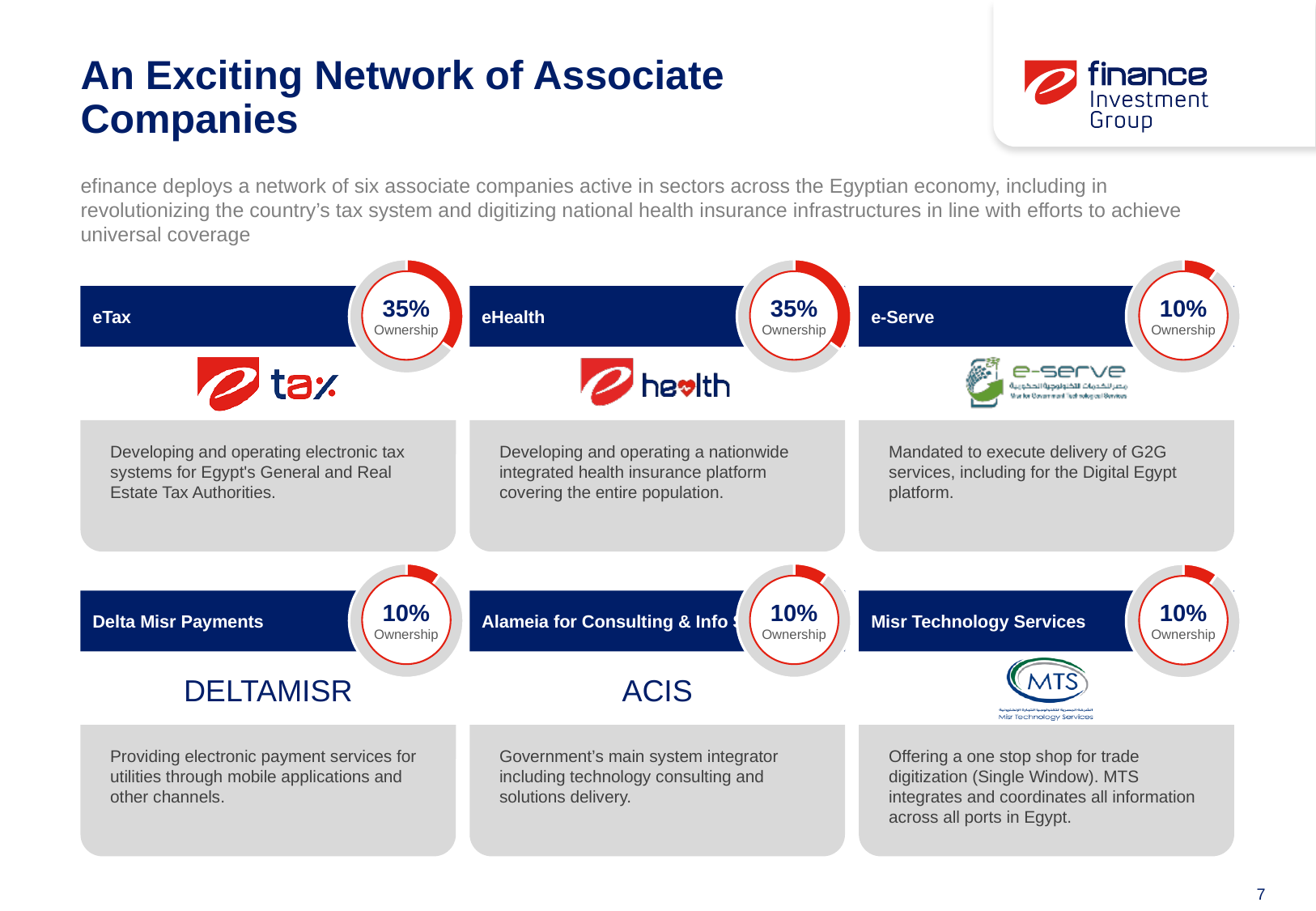
What ownership percentage is shown in the donut chart for eHealth? 35% What ownership percentage is shown in the donut chart for Alameia for Consulting & Info S...? 10% What ownership percentage is shown in the donut chart for Delta Misr Payments? 10% What is the difference between the ownership percentage for eHealth and for Misr Technology Services? 25% What ownership percentage is shown in the donut chart for eTax? 35% What ownership percentage is shown in the donut chart for Misr Technology Services? 10% How many ownership donut charts are shown on the slide? 6 What ownership percentage is shown in the donut chart for e-Serve? 10% What is the highest ownership percentage shown in any of the donut charts? 35% What kind of chart is used to show each company's ownership percentage? Donut chart Which is larger, the ownership percentage for eTax or for e-Serve? eTax What colour is the filled ownership portion of each donut chart? Red